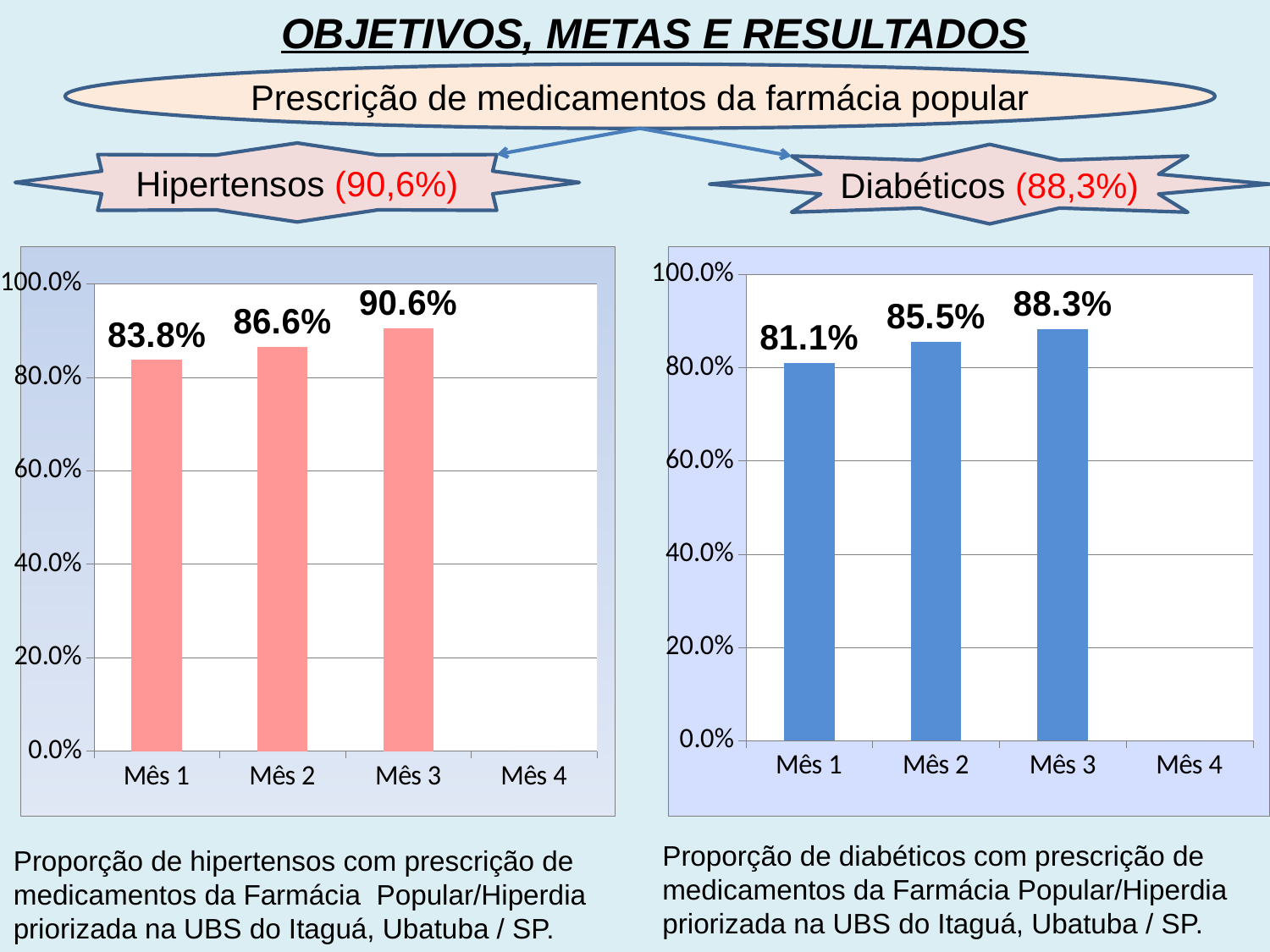
In the right chart (diabéticos), which month has the lowest plotted value? Mês 1 In the left chart (hipertensos), what is the difference between the values for Mês 3 and Mês 1? 6.8% What type of chart is the left chart (hipertensos)? Bar chart In the right chart (diabéticos), do the values rise or fall from Mês 1 to Mês 3? Rise In the left chart (hipertensos), what is the value for Mês 3? 90.6% Which is larger: the Mês 2 value in the left chart (hipertensos) or the Mês 2 value in the right chart (diabéticos)? Left chart (hipertensos), 86.6% In the right chart (diabéticos), what is the value for Mês 2? 85.5% How many month categories are shown on the x axis of the right chart (diabéticos)? 4 In the left chart (hipertensos), what is the value for Mês 1? 83.8% In the right chart (diabéticos), what is the value for Mês 1? 81.1% In the left chart (hipertensos), which month has the highest value? Mês 3 In the right chart (diabéticos), what is the difference between the values for Mês 3 and Mês 2? 2.8%